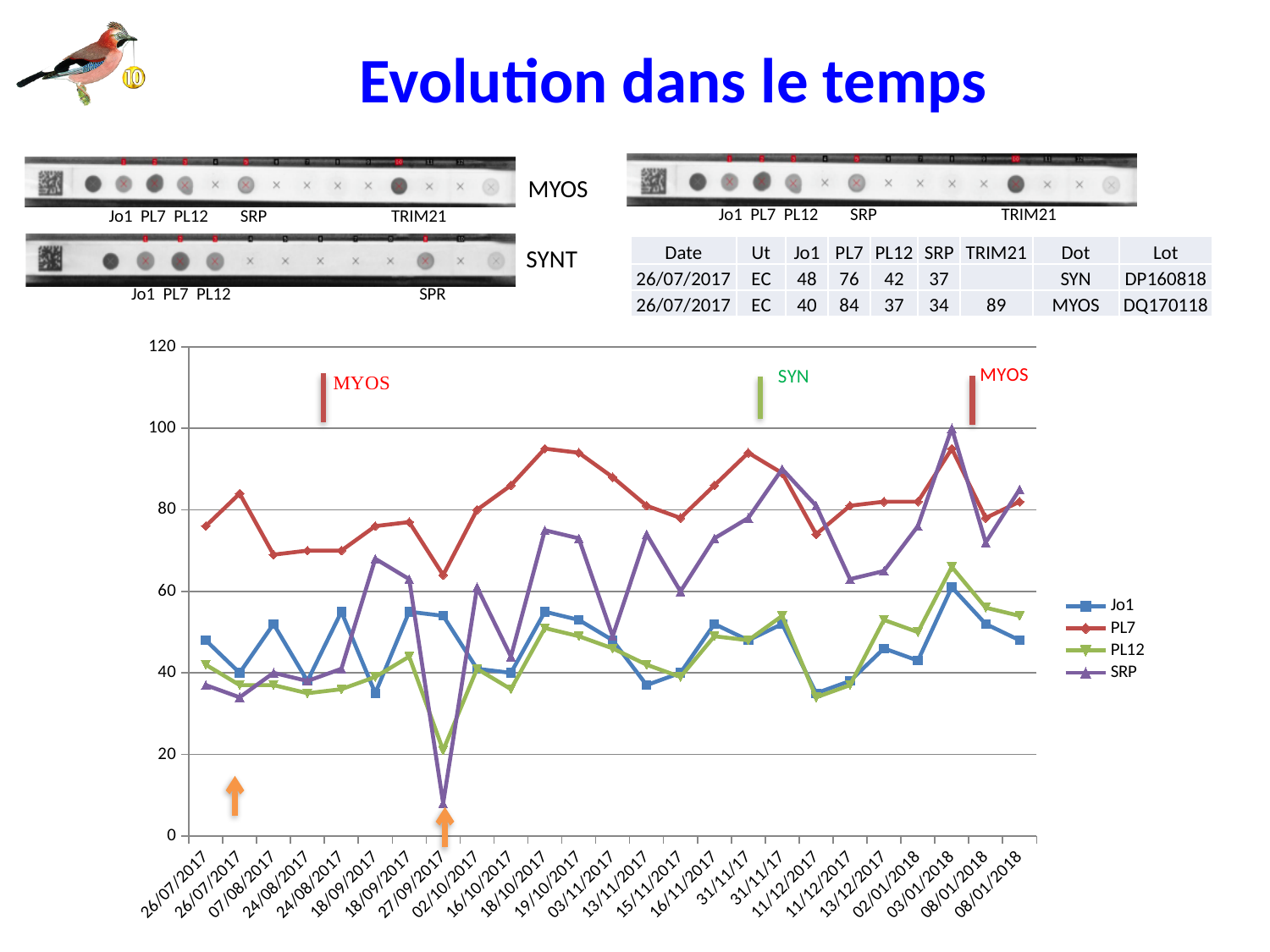
How many series does the chart legend list? 4 Which series stays highest across most of the chart? PL7 Which series drops to the lowest value anywhere on the chart? SRP Does the Jo1 series rise or fall between 11/12/2017 and 03/01/2018? rise What colour is the line for the SRP series? purple Which series are listed in the chart legend? Jo1, PL7, PL12, SRP Is the lowest value of the PL12 series greater or less than 40? less How many data points are plotted along the x axis for each series? 25 What kind of chart is shown on the slide? line chart At the first date on the x axis, which is larger, PL7 or Jo1? PL7 Is the lowest value of the SRP series greater or less than 20? less Is the lowest value of the PL7 series greater or less than 60? greater